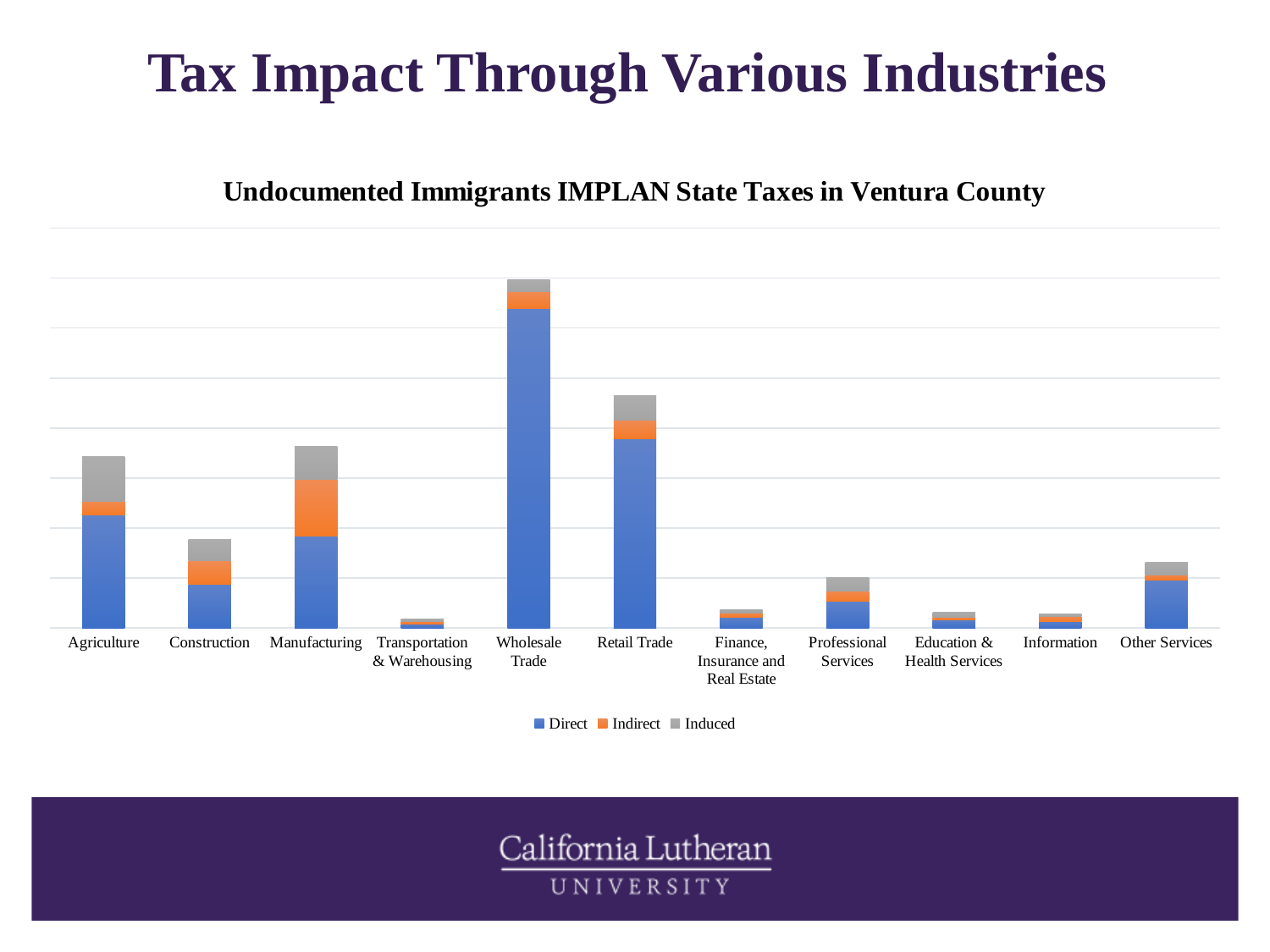
Which has a larger total bar, Agriculture or Construction? Agriculture What kind of chart is shown on the slide? Stacked bar chart Which has a larger total bar, Wholesale Trade or Retail Trade? Wholesale Trade Which industry has the largest Indirect segment? Manufacturing How many series does the legend list? 3 Which has a larger total bar, Other Services or Professional Services? Other Services What is the title of the chart? Undocumented Immigrants IMPLAN State Taxes in Ventura County Which industry has the highest total state tax impact? Wholesale Trade What are the three series named in the legend? Direct, Indirect, Induced How many industry categories are shown on the x axis? 11 Which industry has the largest Direct segment? Wholesale Trade